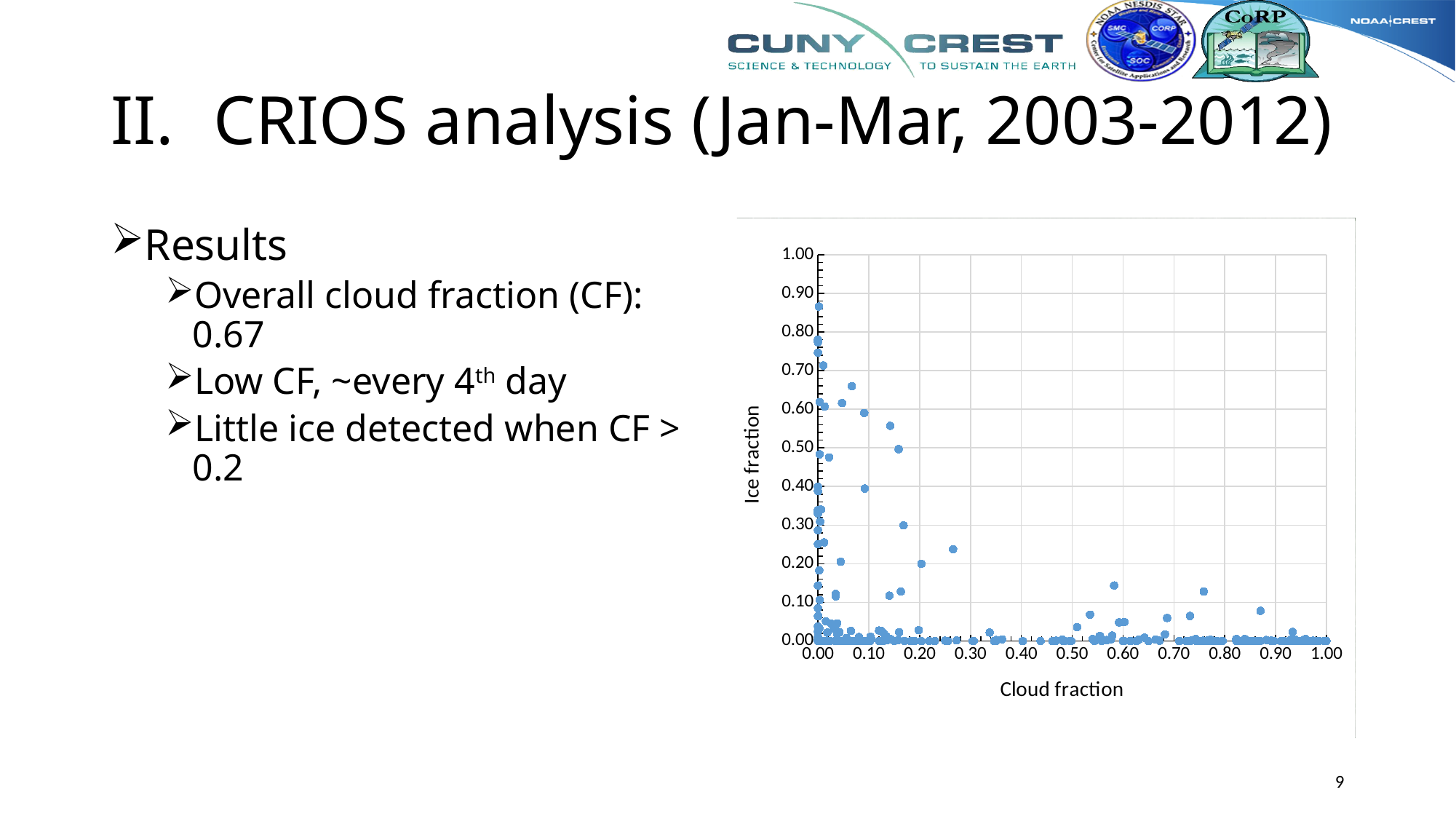
What is the label of the x axis of the chart? Cloud fraction Is the highest ice fraction value plotted on the chart greater or less than 0.90? less What is the label of the y axis of the chart? Ice fraction Do the points with the highest ice fraction occur at low or high cloud fraction? low Is the ice fraction of the point at cloud fraction 0.26 greater or less than 0.30? less Is the highest ice fraction plotted for points with cloud fraction above 0.40 greater or less than 0.20? less What kind of chart is shown on the slide? Scatter chart As cloud fraction increases along the x axis, does the ice fraction of the plotted points generally rise or fall? fall